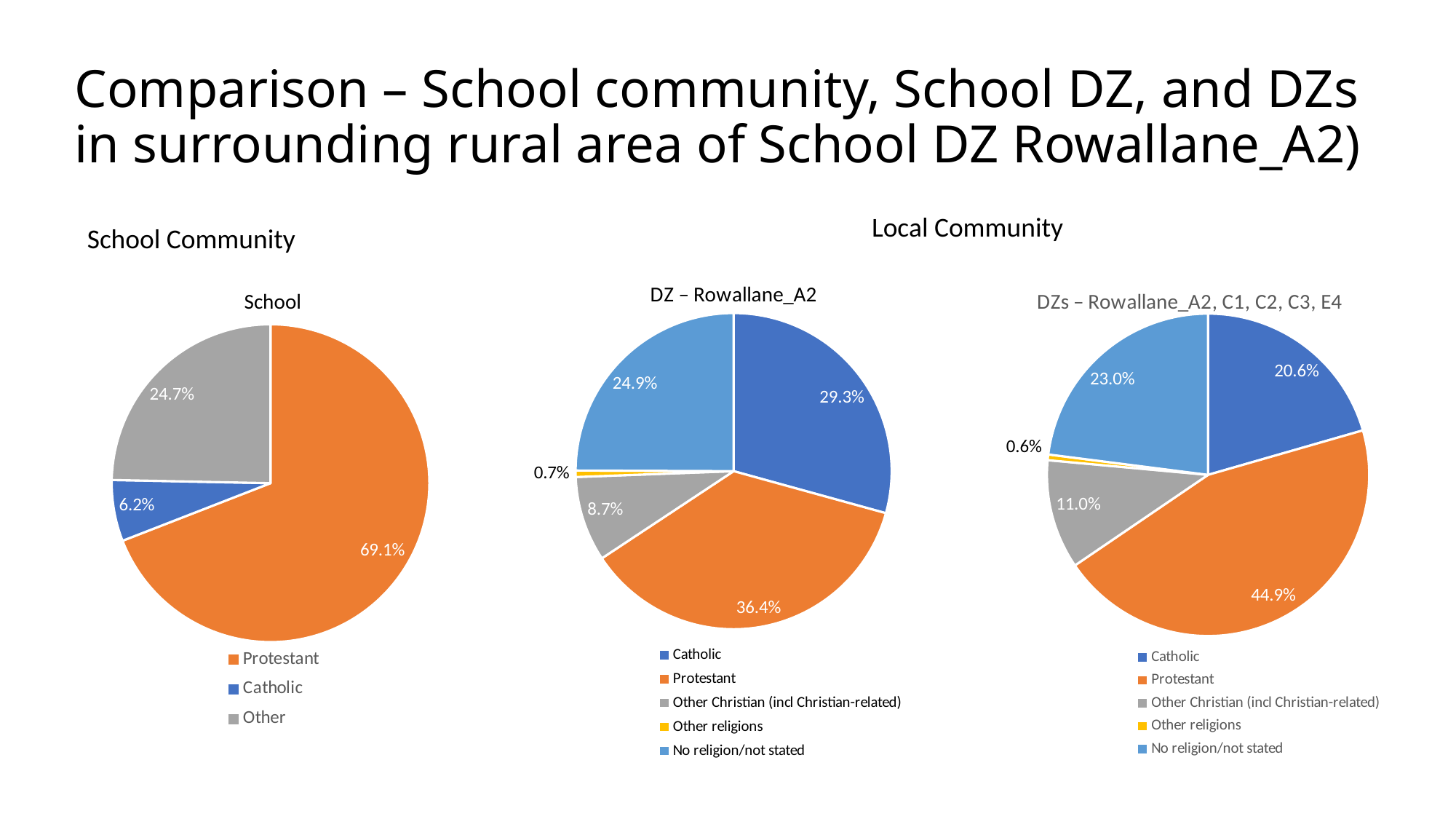
In the 'DZ – Rowallane_A2' pie chart, what is the difference between the Protestant and Catholic shares? 7.1% In the 'DZ – Rowallane_A2' pie chart, which category has the smallest share? Other religions In the 'School' pie chart, what share is Catholic? 6.2% In the 'DZs – Rowallane_A2, C1, C2, C3, E4' pie chart, what share is Other Christian (incl Christian-related)? 11.0% In the 'School' pie chart, what share is Protestant? 69.1% In the 'School' pie chart, what colour is the Other slice? Grey What kind of chart is the 'School' chart? Pie chart How many categories does the legend of the 'DZ – Rowallane_A2' pie chart list? 5 In the 'DZs – Rowallane_A2, C1, C2, C3, E4' pie chart, which category has the largest share? Protestant In the 'DZ – Rowallane_A2' pie chart, what share is Catholic? 29.3% In the 'DZs – Rowallane_A2, C1, C2, C3, E4' pie chart, which is larger: Catholic or No religion/not stated? No religion/not stated In the 'DZ – Rowallane_A2' pie chart, what share is No religion/not stated? 24.9%